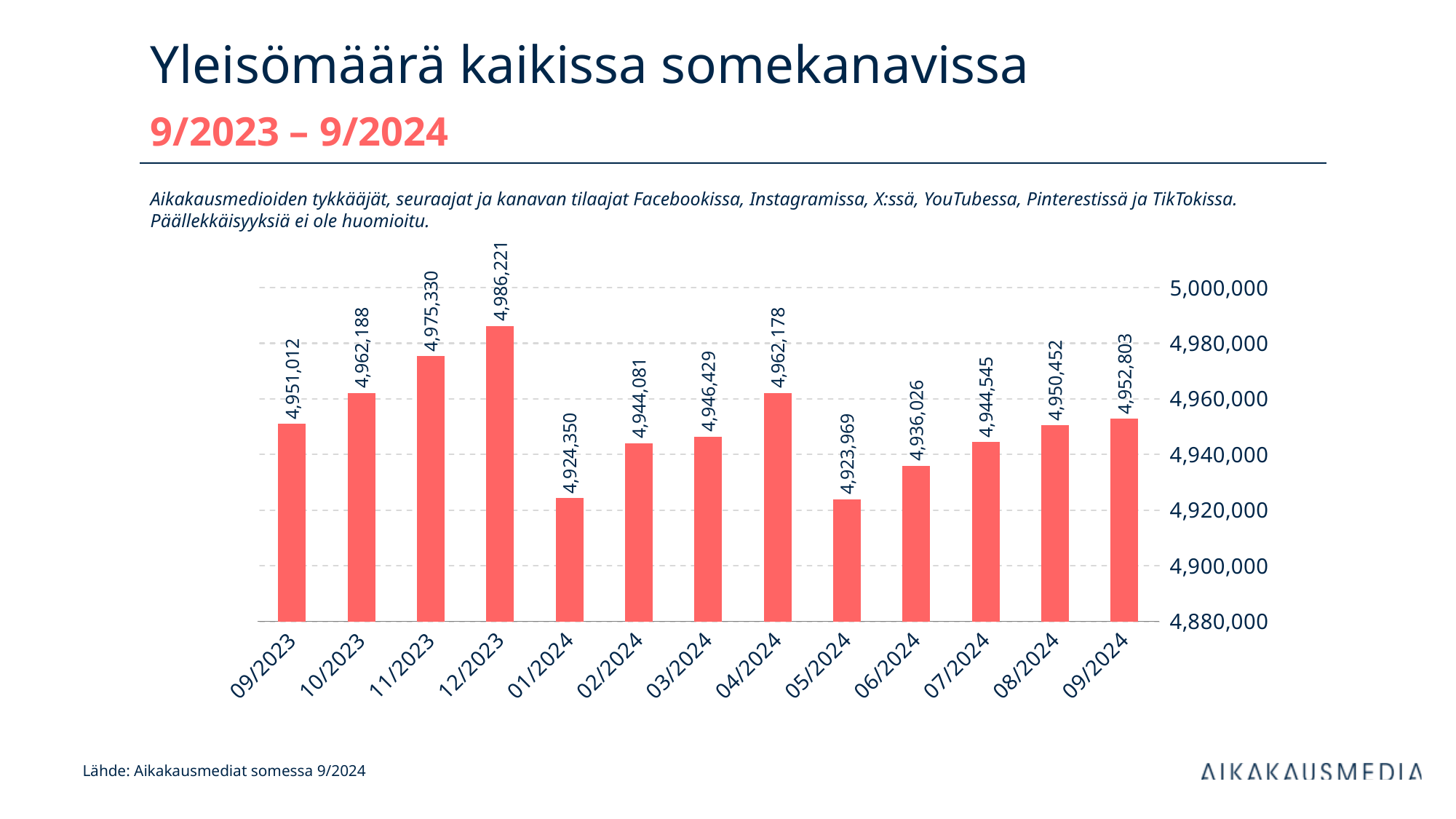
What is the difference between the values for 12/2023 and 09/2023? 35,209 What is the value for 09/2024? 4,952,803 What is the difference between the values for 09/2024 and 09/2023? 1,791 Which is larger, the value for 11/2023 or the value for 04/2024? 11/2023 Which month has the lowest value? 05/2024 How many months are shown on the chart? 13 What is the title of the chart? Yleisömäärä kaikissa somekanavissa Is the value for 11/2023 greater or less than 4,980,000? less What is the value for 05/2024? 4,923,969 What kind of chart is shown on the slide? bar chart Which month has the highest value? 12/2023 What is the value for 12/2023? 4,986,221